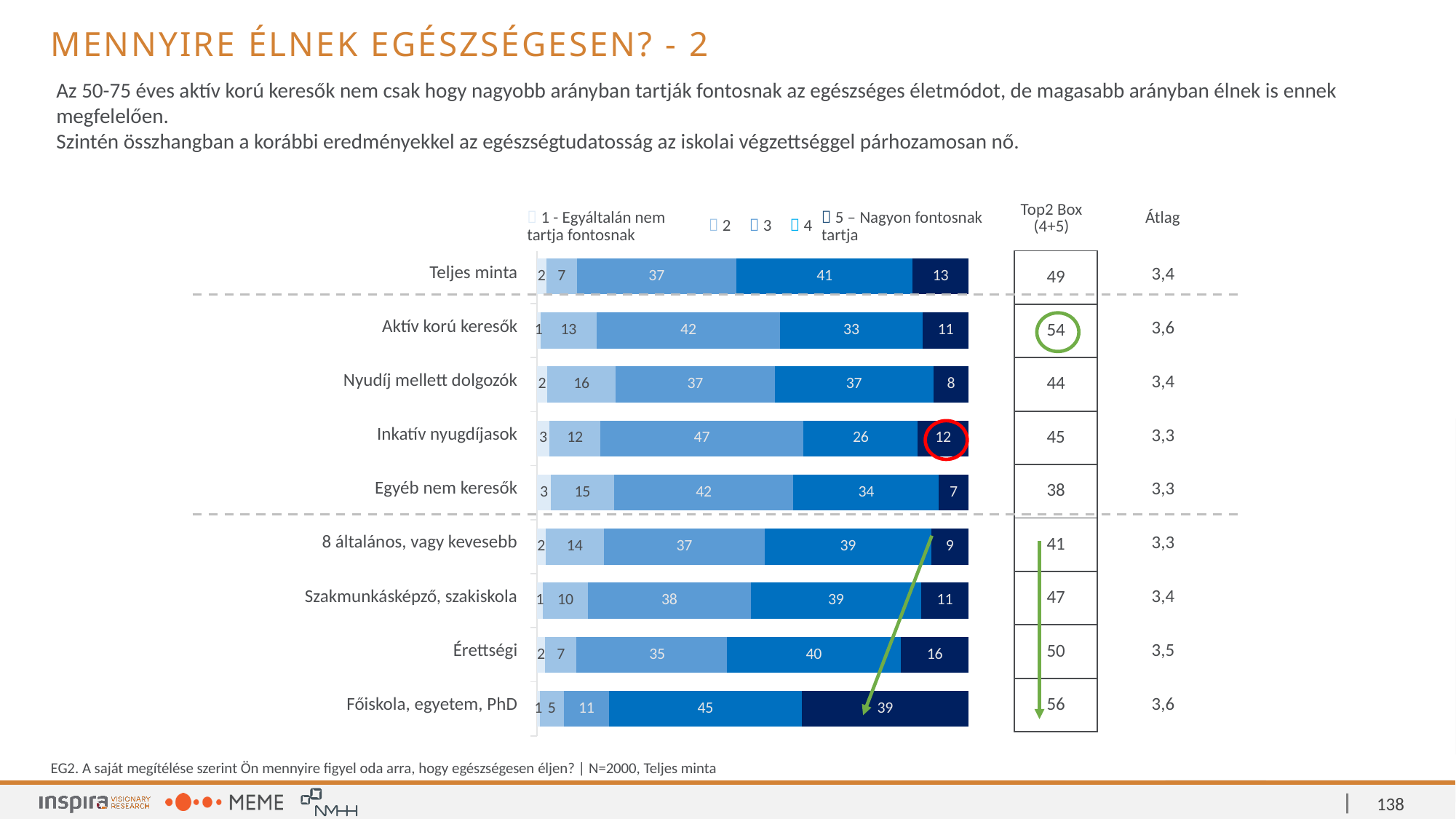
How many series does the legend list? 5 What is the value for "5 – Nagyon fontosnak tartja" in the Főiskola, egyetem, PhD bar? 39 Which has the larger value for "4": Aktív korú keresők or Nyudíj mellett dolgozók? Nyudíj mellett dolgozók Which category has the highest value for "5 – Nagyon fontosnak tartja"? Főiskola, egyetem, PhD What is the value for "3" in the Inkatív nyugdíjasok bar? 47 Which category has the lowest value for "5 – Nagyon fontosnak tartja"? Egyéb nem keresők What is the value for "3" in the Teljes minta bar? 37 What kind of chart is shown on the slide? Stacked bar chart How many categories are shown in the chart? 9 What is the total of the stacked bar for Teljes minta? 100 What is the first legend entry of the chart? 1 - Egyáltalán nem tartja fontosnak What is the difference between the "5 – Nagyon fontosnak tartja" values for Érettségi and Szakmunkásképző, szakiskola? 5